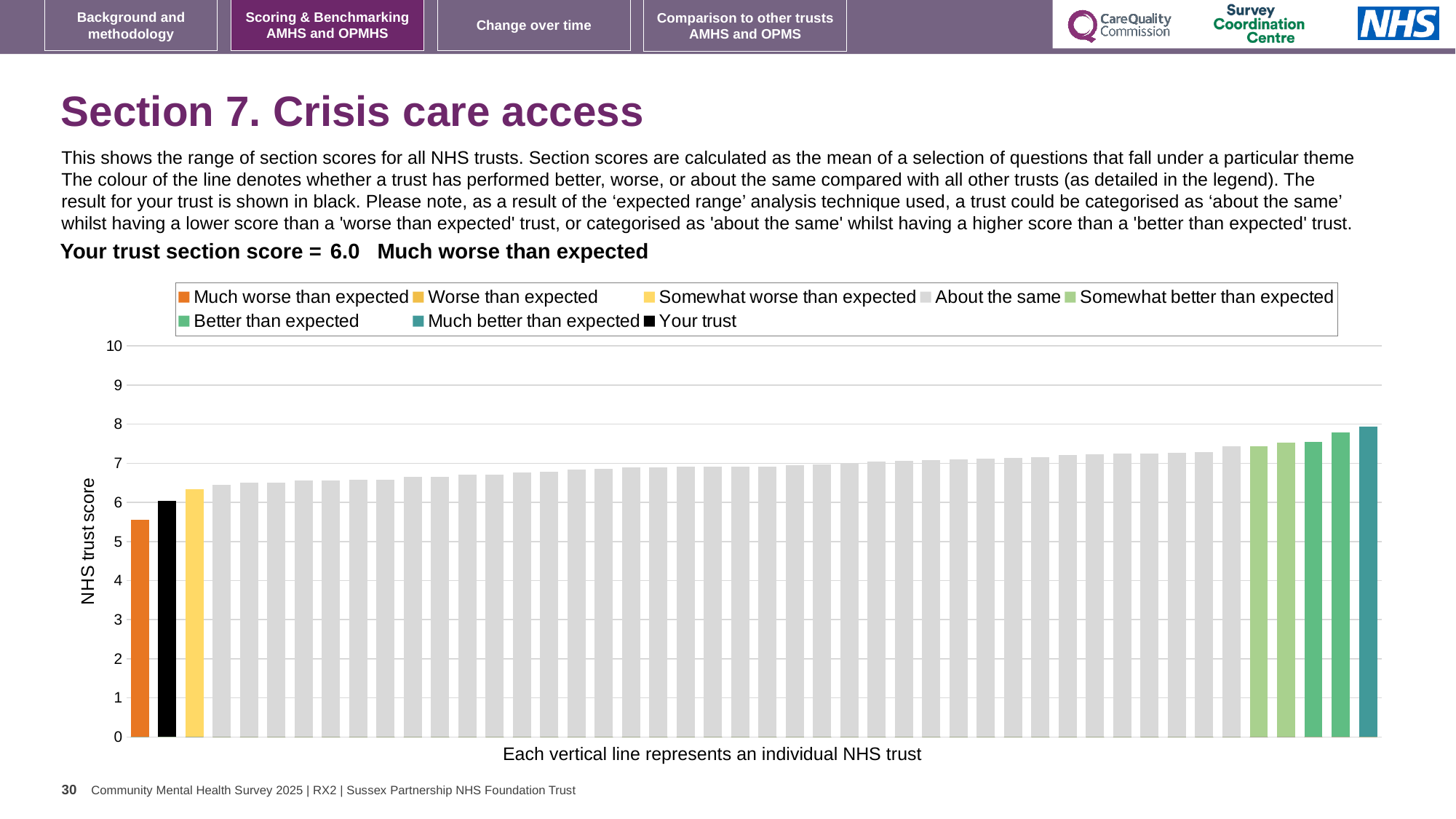
Is the value of the 'Your trust' bar greater or less than 5? greater What is the section score for your trust? 6.0 What kind of chart is shown on the slide? bar chart How many entries does the chart legend list? 8 Which is larger: the 'Your trust' bar or the 'Much worse than expected' (orange) bar? Your trust Which category is your trust's section score placed in? Much worse than expected Is the value of the 'Much worse than expected' (orange) bar greater or less than 6? less Which legend category does the lowest bar belong to? Much worse than expected What is the label on the vertical axis of the chart? NHS trust score Which legend category does the highest bar belong to? Much better than expected Do the bar values rise or fall from left to right along the x axis? rise